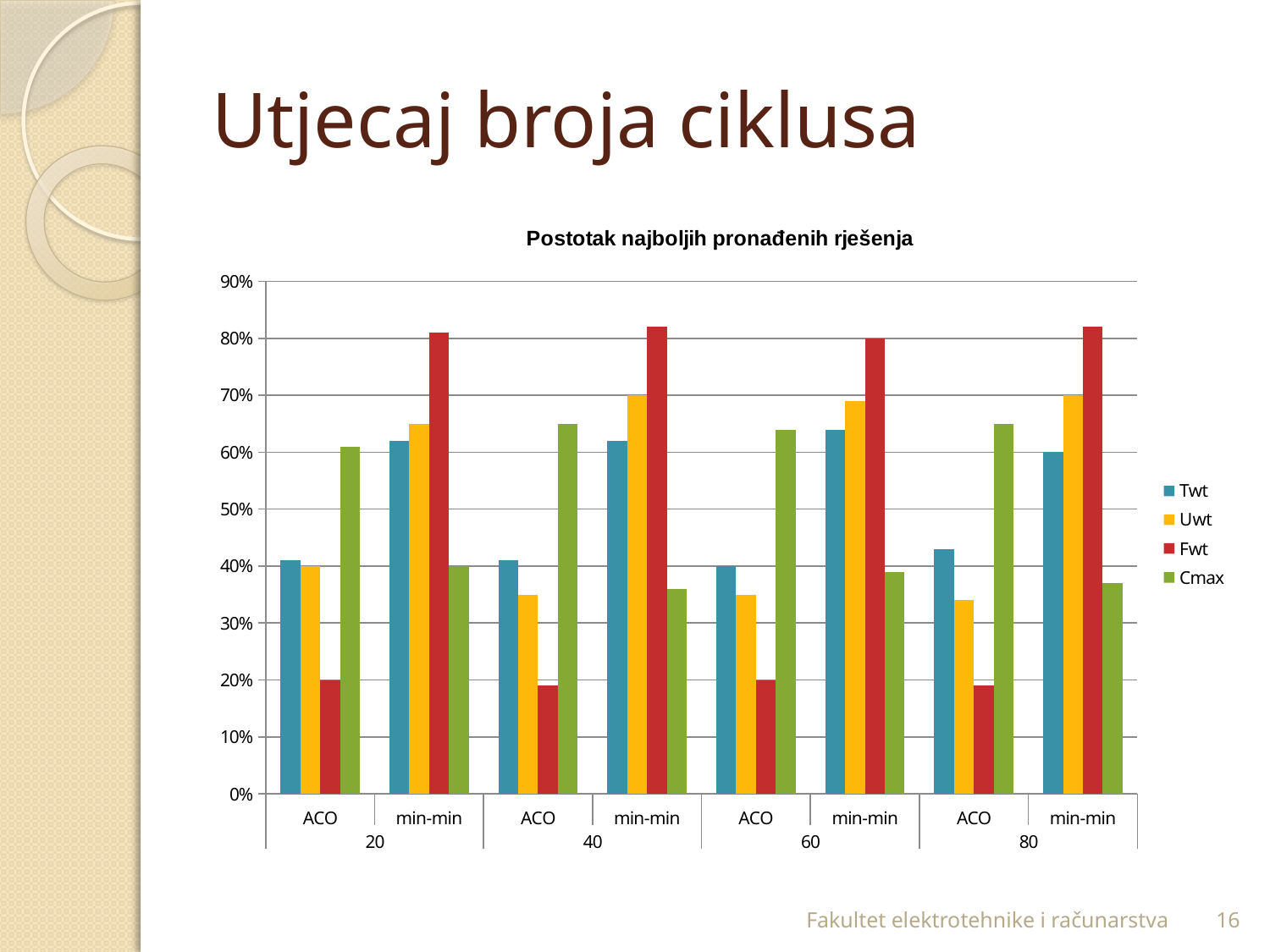
Is the value of Fwt for min-min at 20 cycles greater or less than 70%? greater Which series is shown in red in the legend? Fwt Which series has the highest value for min-min at 40 cycles? Fwt How many series does the legend list? 4 For ACO at 20 cycles, which is larger: the Cmax value or the Twt value? Cmax Is the value of Cmax for ACO at 60 cycles greater or less than 50%? greater Is the value of Fwt for ACO at 40 cycles greater or less than 30%? less What is the title of the chart? Postotak najboljih pronađenih rješenja For min-min at 60 cycles, which is larger: the Uwt value or the Cmax value? Uwt Which series has the lowest value for ACO at 80 cycles? Fwt What kind of chart is shown on the slide? bar chart